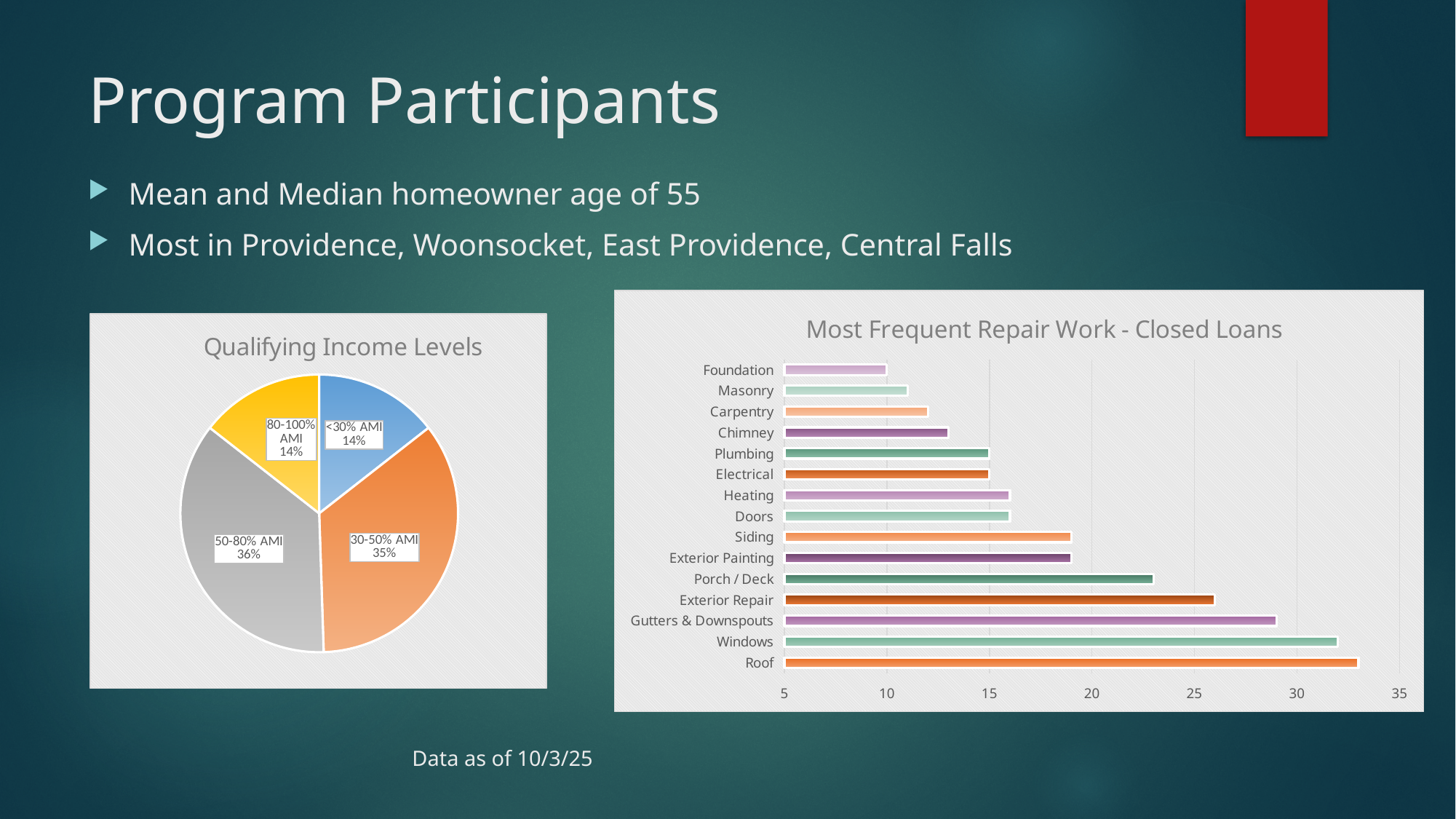
In the Qualifying Income Levels chart, what value is shown for 30-50% AMI? 35% What kind of chart is the Most Frequent Repair Work - Closed Loans chart? bar chart In the Most Frequent Repair Work - Closed Loans chart, which is larger, Exterior Repair or Siding? Exterior Repair How many repair types are listed in the Most Frequent Repair Work - Closed Loans chart? 15 In the Most Frequent Repair Work - Closed Loans chart, which repair type has the lowest value? Foundation In the Qualifying Income Levels chart, what value is shown for <30% AMI? 14% In the Most Frequent Repair Work - Closed Loans chart, which repair type has the highest value? Roof In the Qualifying Income Levels chart, what share of the pie is the 50-80% AMI slice? 36% What kind of chart is the Qualifying Income Levels chart? pie chart How many slices does the Qualifying Income Levels pie chart have? 4 In the Most Frequent Repair Work - Closed Loans chart, is the value for Windows greater or less than 30? greater In the Qualifying Income Levels chart, which income level has the largest slice? 50-80% AMI